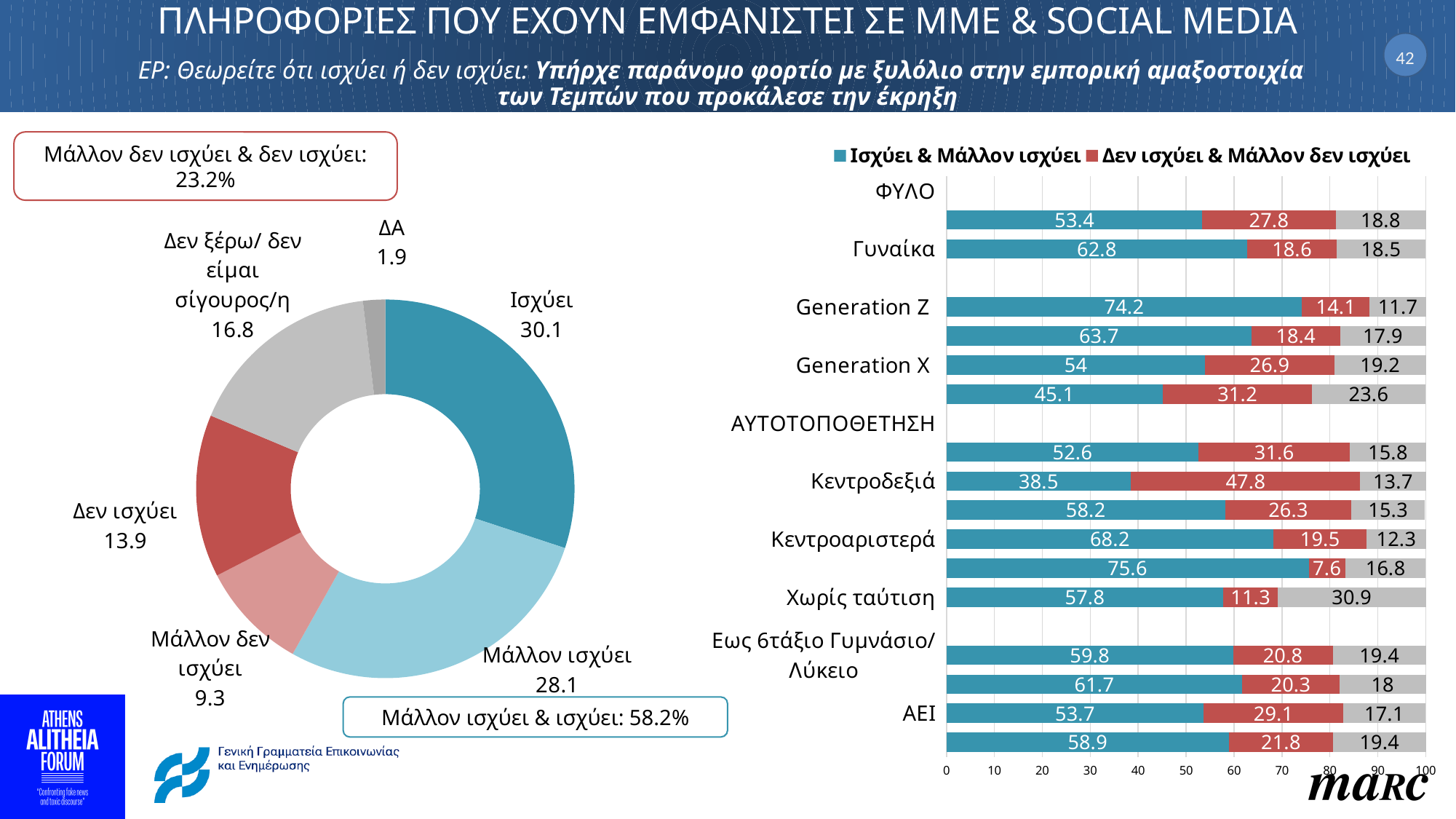
In the stacked bar chart on the right, which is larger for Ισχύει & Μάλλον ισχύει: Γυναίκα or ΑΕΙ? Γυναίκα In the stacked bar chart on the right, what is the value of Ισχύει & Μάλλον ισχύει for Generation Z? 74.2 In the stacked bar chart on the right, what is the difference in Ισχύει & Μάλλον ισχύει between Κεντροαριστερά and Κεντροδεξιά? 29.7 In the donut chart on the left, how many categories are shown? 6 What type of chart is shown on the right side of the slide? Stacked bar chart In the donut chart on the left, which category has the smallest value? ΔΑ In the stacked bar chart on the right, what is the value of Δεν ισχύει & Μάλλον δεν ισχύει for Κεντροδεξιά? 47.8 In the donut chart on the left, what is the difference between Δεν ισχύει and Μάλλον δεν ισχύει? 4.6 In the donut chart on the left, what is the value for Ισχύει? 30.1 In the donut chart on the left, what is the value for Μάλλον δεν ισχύει? 9.3 How many series does the legend of the stacked bar chart on the right list? 2 In the donut chart on the left, which category has the largest value? Ισχύει